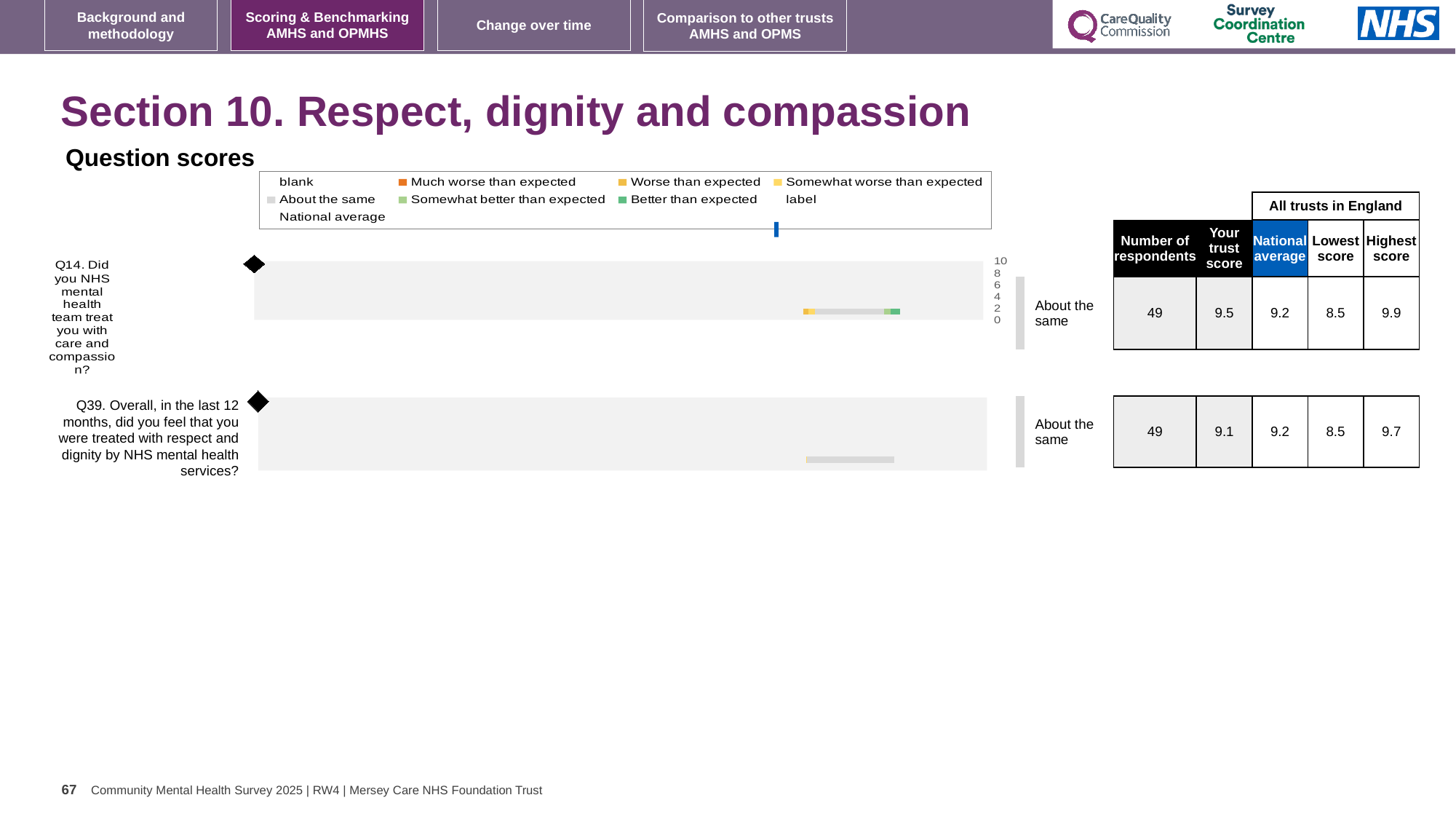
What is the difference between the highest and lowest scores across all trusts for Q39? 1.2 What is the trust score for Q14 (care and compassion) shown next to the chart? 9.5 What benchmark category is shown for Q39 in the chart? About the same What is the highest score across all trusts in England for Q39? 9.7 What is the national average for Q14 shown next to the chart? 9.2 How many questions (categories) are plotted in the Question scores chart? 2 How many respondents answered Q39? 49 Which question has the higher trust score, Q14 or Q39? Q14 What is the lowest score across all trusts in England for Q14? 8.5 What is the trust score for Q39 (respect and dignity) shown next to the chart? 9.1 What is the difference between the trust score and the national average for Q14? 0.3 Which legend entry is shown with an orange marker in the chart legend? Much worse than expected